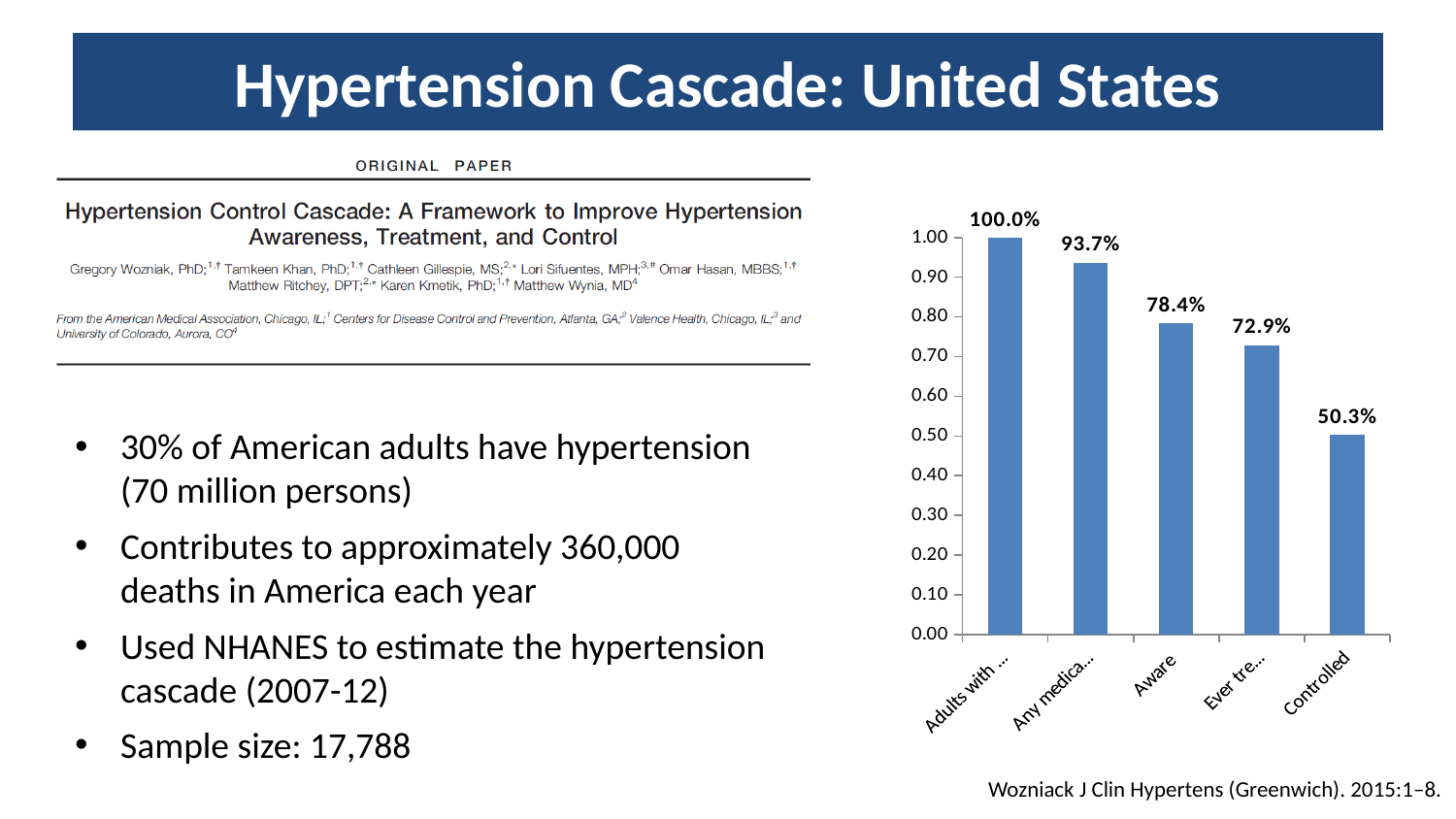
What is the value shown for the Controlled bar? 50.3% What is the value shown on the second bar from the left? 93.7% Which category has the lowest value in the chart? Controlled What is the value shown on the first (leftmost) bar of the chart? 100.0% Which is larger, the value for Aware or the value for Controlled? Aware What is the value shown for the Aware bar? 78.4% Do the bar values rise or fall from left to right across the chart? fall What is the difference between the Aware value and the Controlled value? 28.1% What is the value shown on the fourth bar from the left? 72.9% What type of chart is shown on the slide? bar chart How many bars are plotted in the chart? 5 Is the value for Controlled greater or less than 0.60 on the axis? less